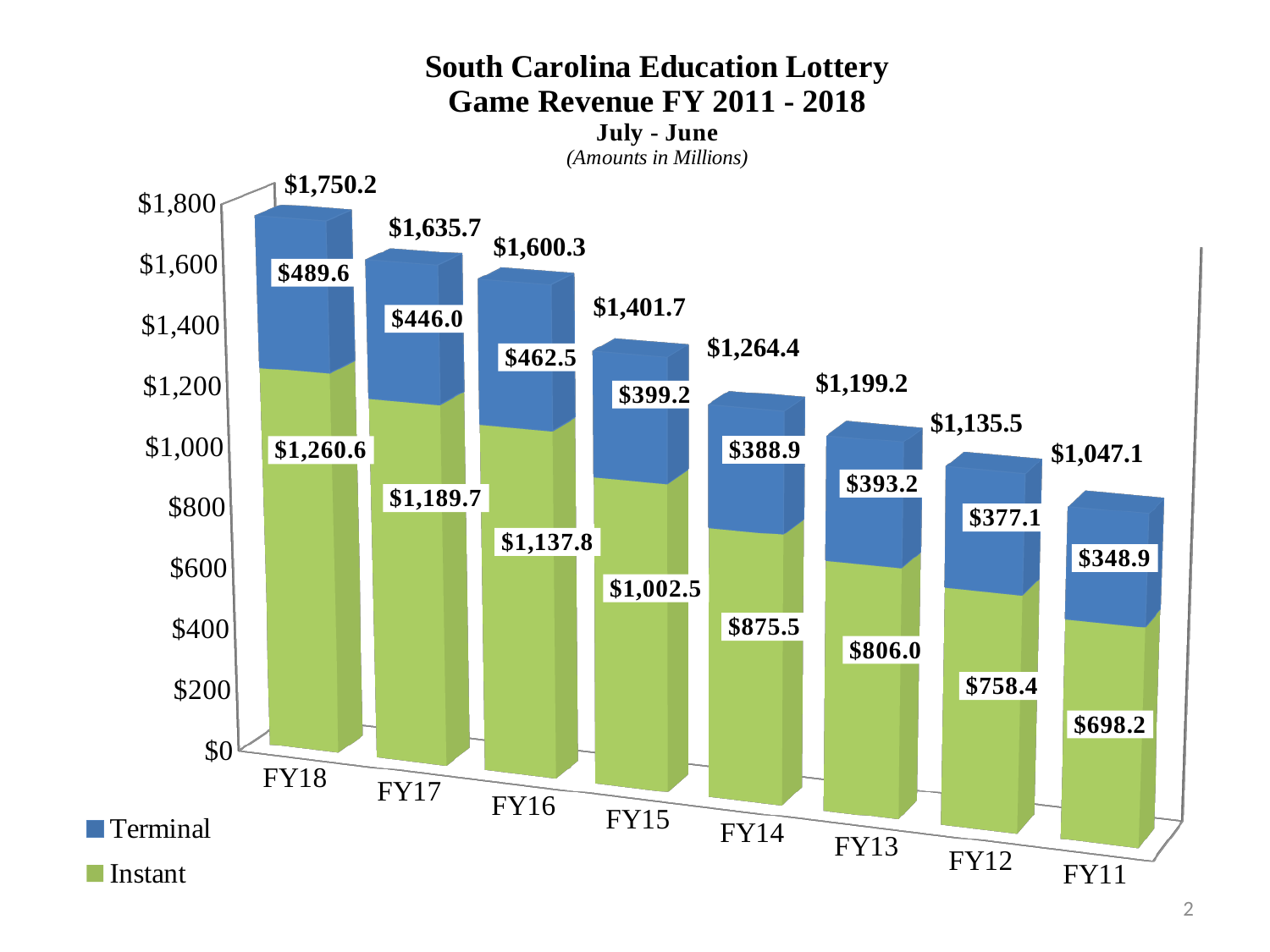
What is the Instant revenue for FY18? $1,260.6 Which fiscal year has the lowest Instant revenue? FY11 How much larger is Instant revenue in FY16 than in FY15? $135.3 Which is larger, Terminal revenue in FY16 or in FY17? FY16 What is the total game revenue shown for FY13? $1,199.2 What is the Terminal revenue for FY15? $399.2 Do the total revenues rise or fall moving from FY18 on the left to FY11 on the right? Fall What is the difference between Terminal revenue in FY18 and FY17? $43.6 Which fiscal year has the highest total game revenue? FY18 What kind of chart is shown on the slide? Stacked bar chart How many series does the legend list? 2 How many fiscal years are shown on the chart? 8